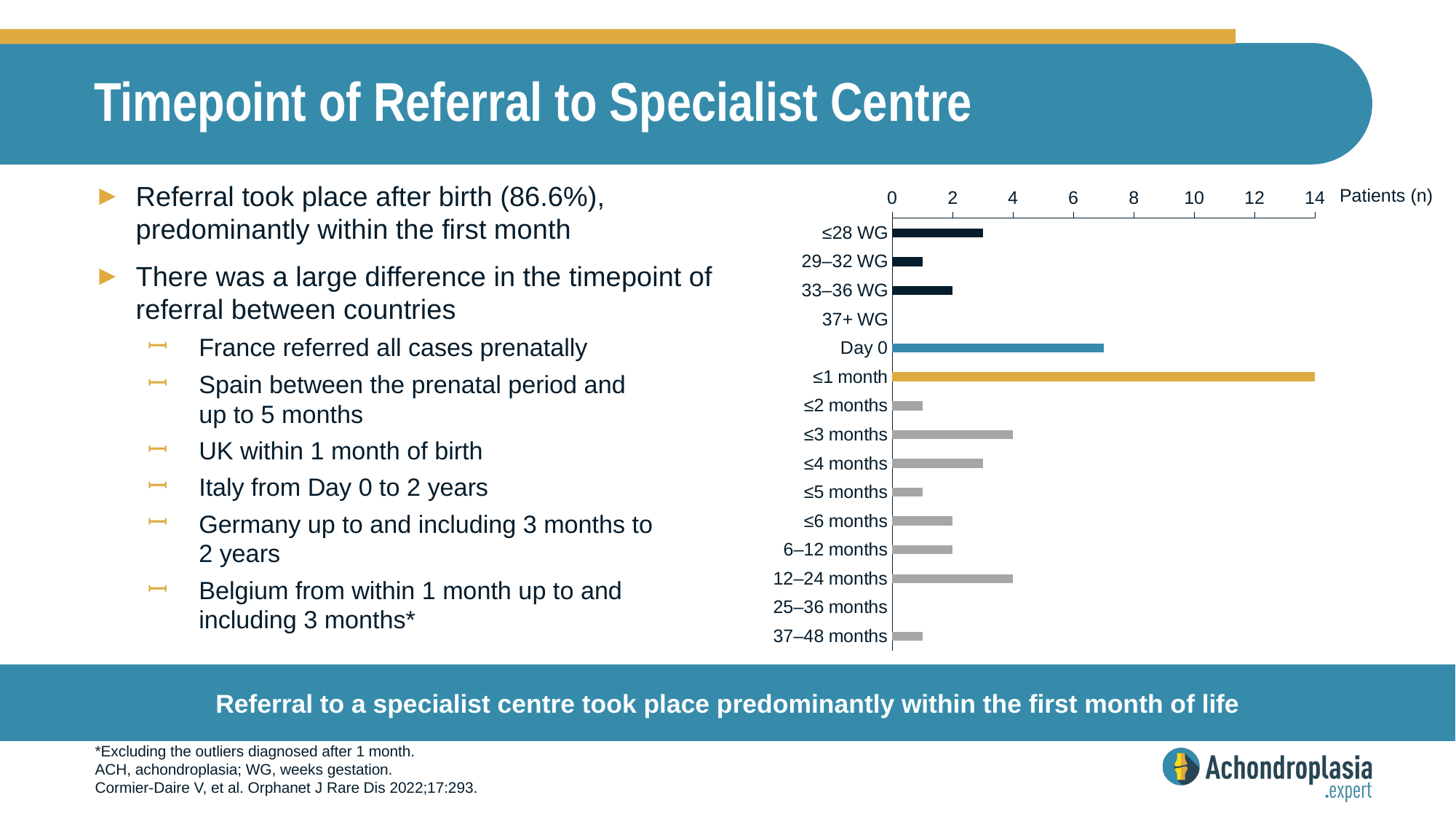
Is the value for ≤28 WG greater or less than 4? less How many timepoint categories are listed on the chart's vertical axis? 15 What is the highest value shown on the horizontal axis of the chart? 14 How many patients were referred at ≤3 months? 4 Is the value for Day 0 greater or less than 6? greater Which category has the highest number of patients? ≤1 month Is the value for ≤4 months greater or less than 2? greater What is the difference in patients between the ≤1 month and ≤3 months categories? 10 How many patients were referred at ≤1 month? 14 Which has more patients, Day 0 or ≤3 months? Day 0 What kind of chart is shown on the slide? bar chart What is the label of the horizontal axis of the chart? Patients (n)